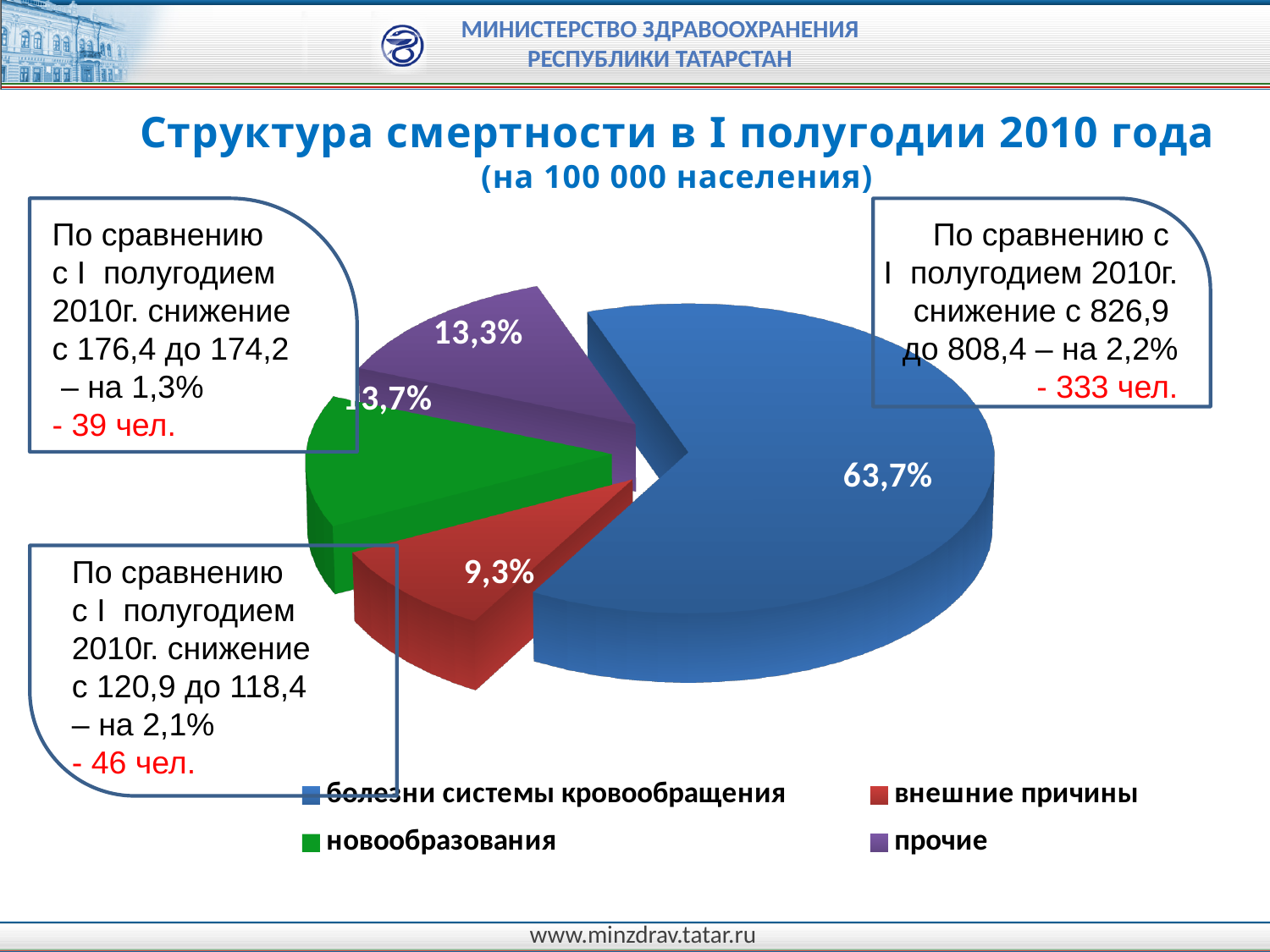
How many categories does the pie chart have? 4 What share of the pie does внешние причины have? 9,3% What kind of chart is shown on the slide? pie chart Which category has the smallest slice of the pie? внешние причины What is the difference between the share for болезни системы кровообращения and the share for прочие? 50,4% What colour is the slice for новообразования? green What share of the pie does прочие have? 13,3% What is the title of the chart on the slide? Структура смертности в I полугодии 2010 года (на 100 000 населения) How many entries does the legend list? 4 What share of the pie does болезни системы кровообращения have? 63,7% Which category has the largest slice of the pie? болезни системы кровообращения Which is larger, the share for прочие or the share for внешние причины? прочие